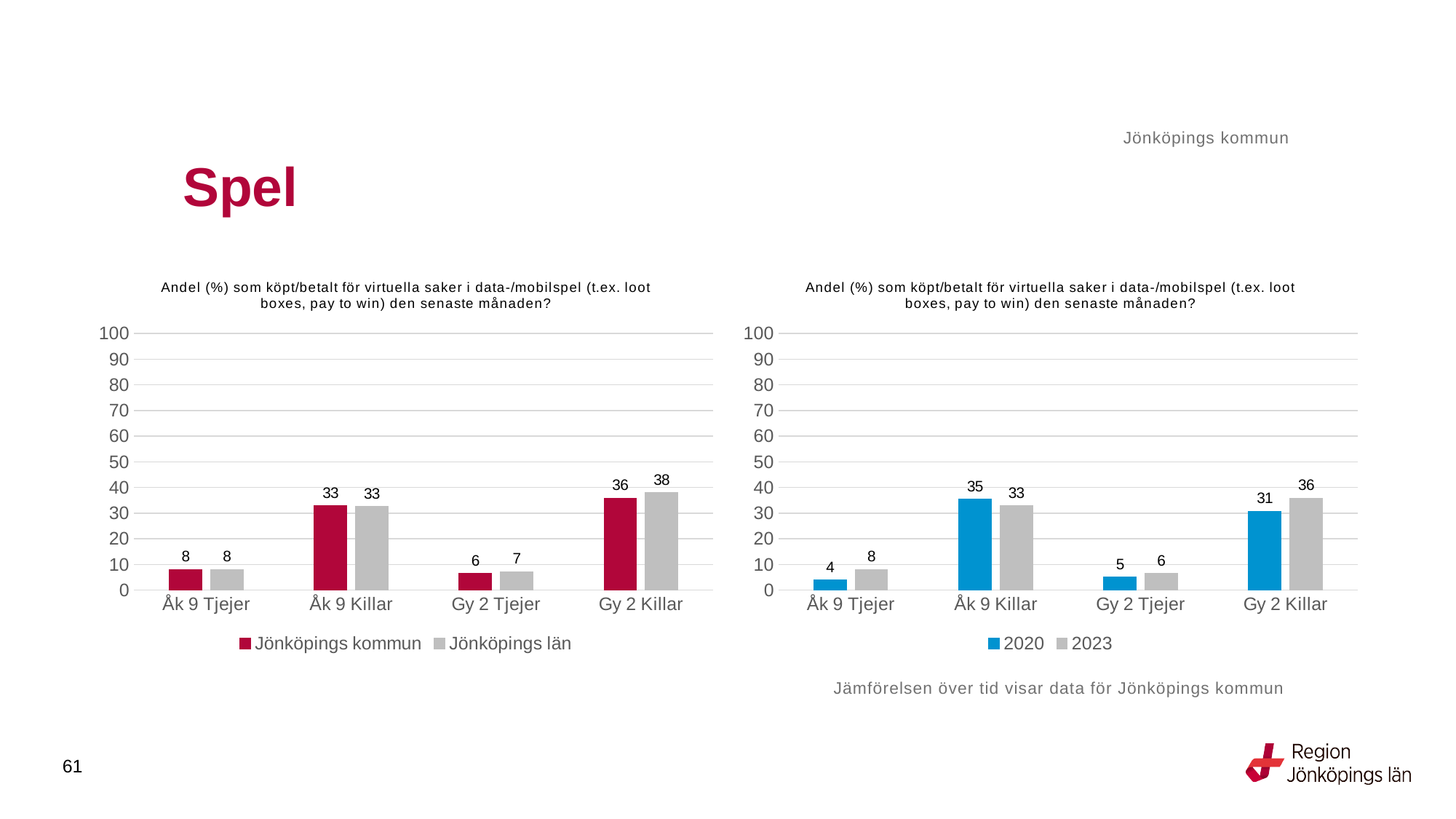
In the right chart, what is the difference between the 2023 and 2020 values for Gy 2 Killar? 5 In the left chart, which category has the highest Jönköpings kommun value? Gy 2 Killar How many series does the legend of the right chart list? 2 In the right chart, which is larger for Åk 9 Killar: the 2020 value or the 2023 value? 2020 In the left chart, what is the value for Jönköpings kommun for Åk 9 Killar? 33 In the right chart, which category has the lowest 2020 value? Åk 9 Tjejer In the left chart, what is the value for Jönköpings län for Gy 2 Killar? 38 What kind of chart is the left chart? Bar chart In the left chart, is the Jönköpings län value for Gy 2 Killar greater or less than 30? greater In the right chart, what is the 2020 value for Åk 9 Tjejer? 4 How many categories are shown on the x axis of the left chart? 4 In the right chart, what is the 2023 value for Gy 2 Killar? 36